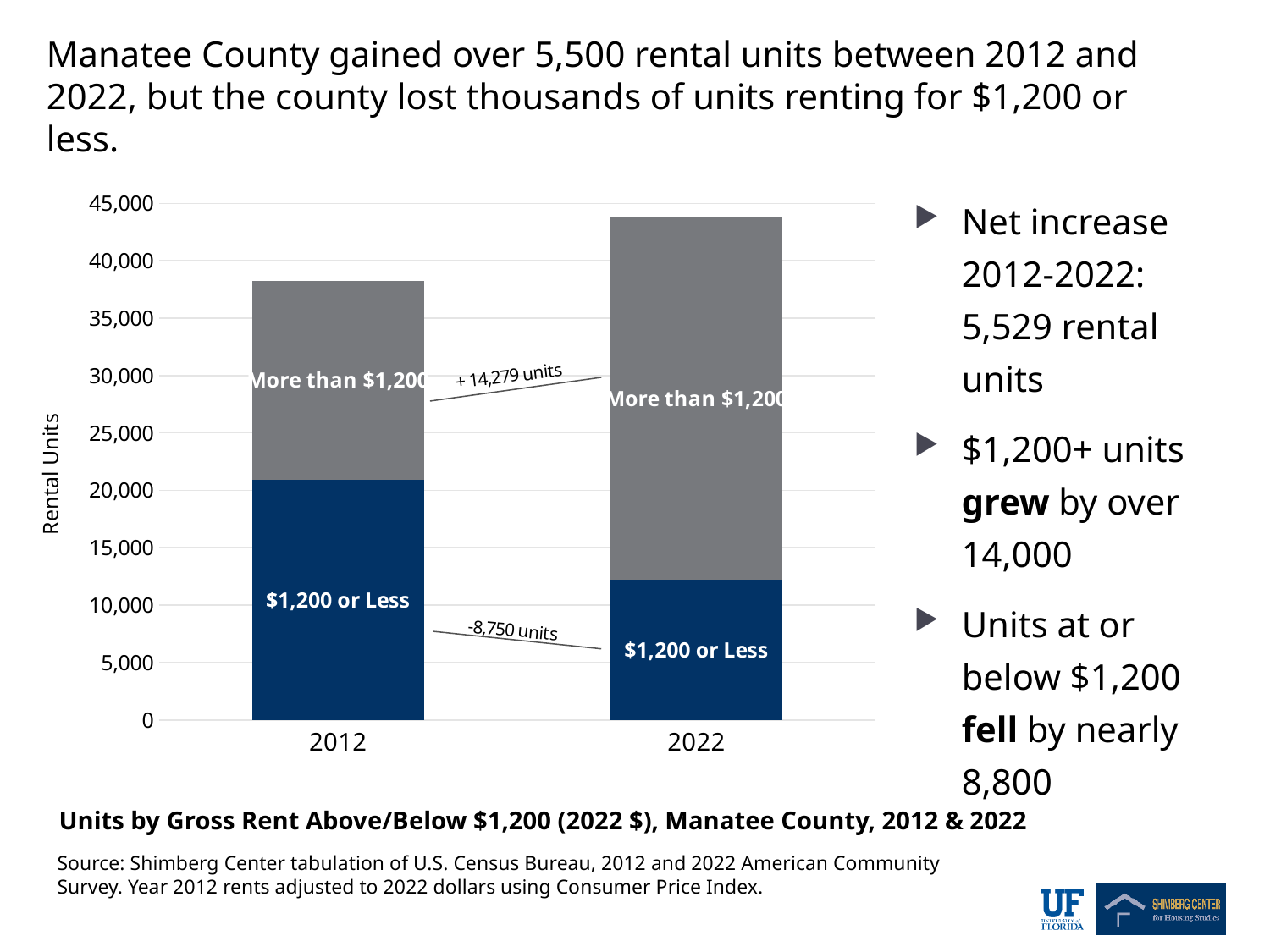
How many years (categories) are shown on the x axis of the chart? 2 What is the title of the chart? Units by Gross Rent Above/Below $1,200 (2022 $), Manatee County, 2012 & 2022 Is the '$1,200 or Less' segment in 2022 greater or less than 15,000? less Is the total height of the 2012 bar greater or less than 35,000? greater According to the annotation on the chart, by how many units did the '$1,200 or Less' segment change from 2012 to 2022? -8,750 units According to the annotation on the chart, by how many units did the 'More than $1,200' segment change from 2012 to 2022? + 14,279 units What kind of chart is shown on the slide? stacked bar chart Does the total number of rental units rise or fall from 2012 to 2022? rise What is the label on the vertical axis of the chart? Rental Units Is the total height of the 2022 bar greater or less than 45,000? less How many rent segments (series) are stacked in each bar? 2 Which year has the larger '$1,200 or Less' segment, 2012 or 2022? 2012